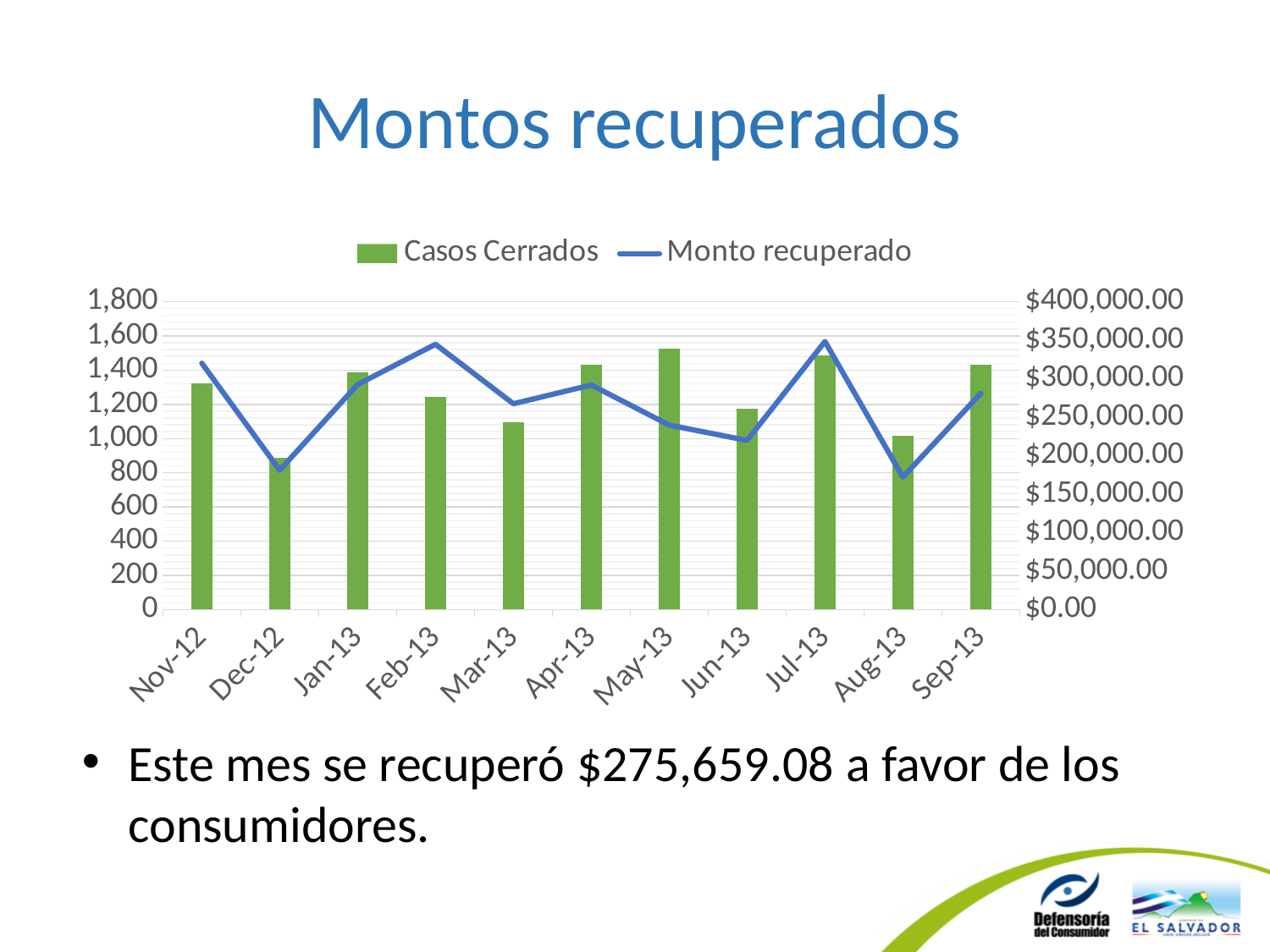
Is the Monto recuperado value for Feb-13 greater or less than $300,000.00? greater Is the Casos Cerrados value for Dec-12 greater or less than 1,000? less Is the Casos Cerrados value for May-13 greater or less than 1,400? greater What kind of chart is shown? Combination bar and line chart Which month has more Casos Cerrados, Nov-12 or Dec-12? Nov-12 What is the title of the chart? Montos recuperados Which series is drawn as a line rather than bars? Monto recuperado Which month has a higher Monto recuperado, Feb-13 or Mar-13? Feb-13 Which month has the lowest number of Casos Cerrados? Dec-12 How many series does the legend list? 2 How many months are shown on the x axis? 11